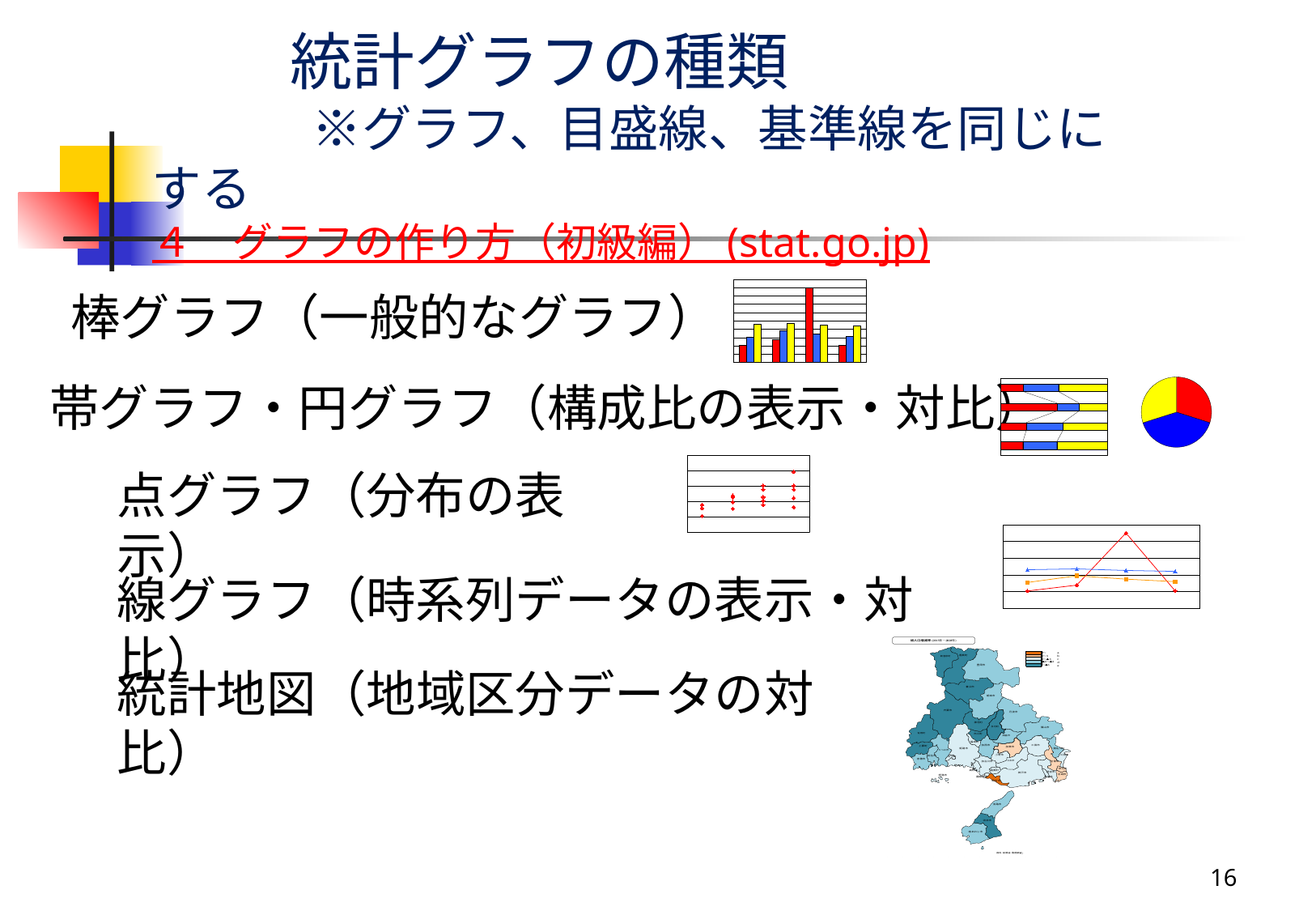
How many slices does the pie chart on the slide have? 3 What kind of chart is the circular chart at the right of the 帯グラフ・円グラフ line? pie chart What kind of chart is shown next to the text 棒グラフ（一般的なグラフ）? bar chart How many lines are plotted in the line chart on the slide? 3 In the line chart, which coloured line reaches the highest point? red What three colours are used for the slices of the pie chart? red, yellow, blue What colour are the markers in the dot chart next to 点グラフ? red What kind of chart is shown next to the text 線グラフ（時系列データの表示・対比）? line chart How many horizontal bars are in the band (帯) chart next to the 帯グラフ・円グラフ line? 4 In the bar chart next to 棒グラフ, what colour is the tallest bar? red